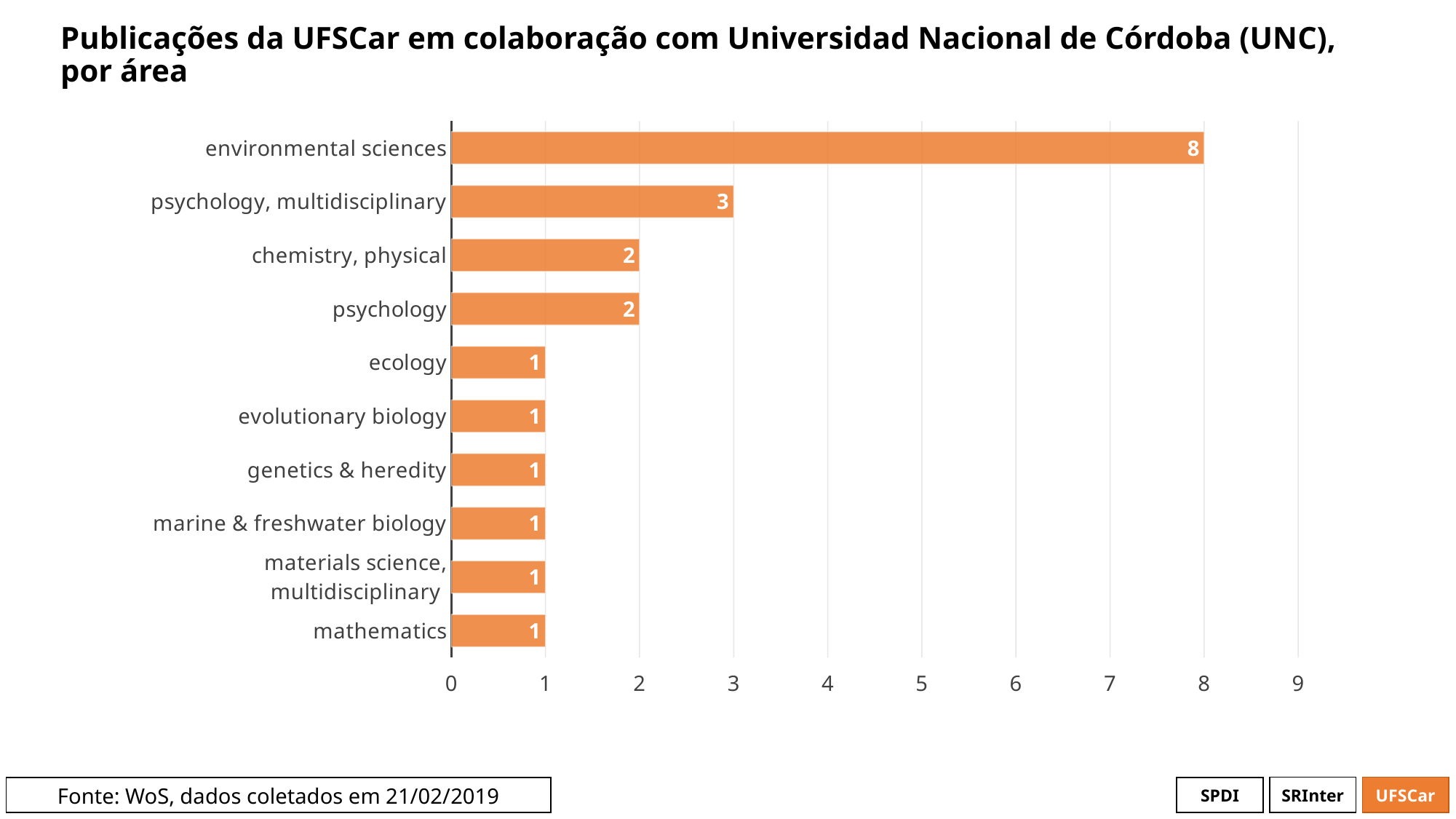
What is the value for chemistry, physical? 2 Which area has the highest number of publications? environmental sciences What is the value for psychology, multidisciplinary? 3 What kind of chart is shown on the slide? bar chart What is the data source stated on the slide? WoS, dados coletados em 21/02/2019 How many areas have a value of 1? 6 What is the difference between the values for environmental sciences and psychology, multidisciplinary? 5 How many publications are shown for environmental sciences? 8 What is the value for mathematics? 1 Which is larger, the value for psychology, multidisciplinary or the value for psychology? psychology, multidisciplinary Is the value for environmental sciences greater or less than 5? greater How many areas are shown in the chart? 10